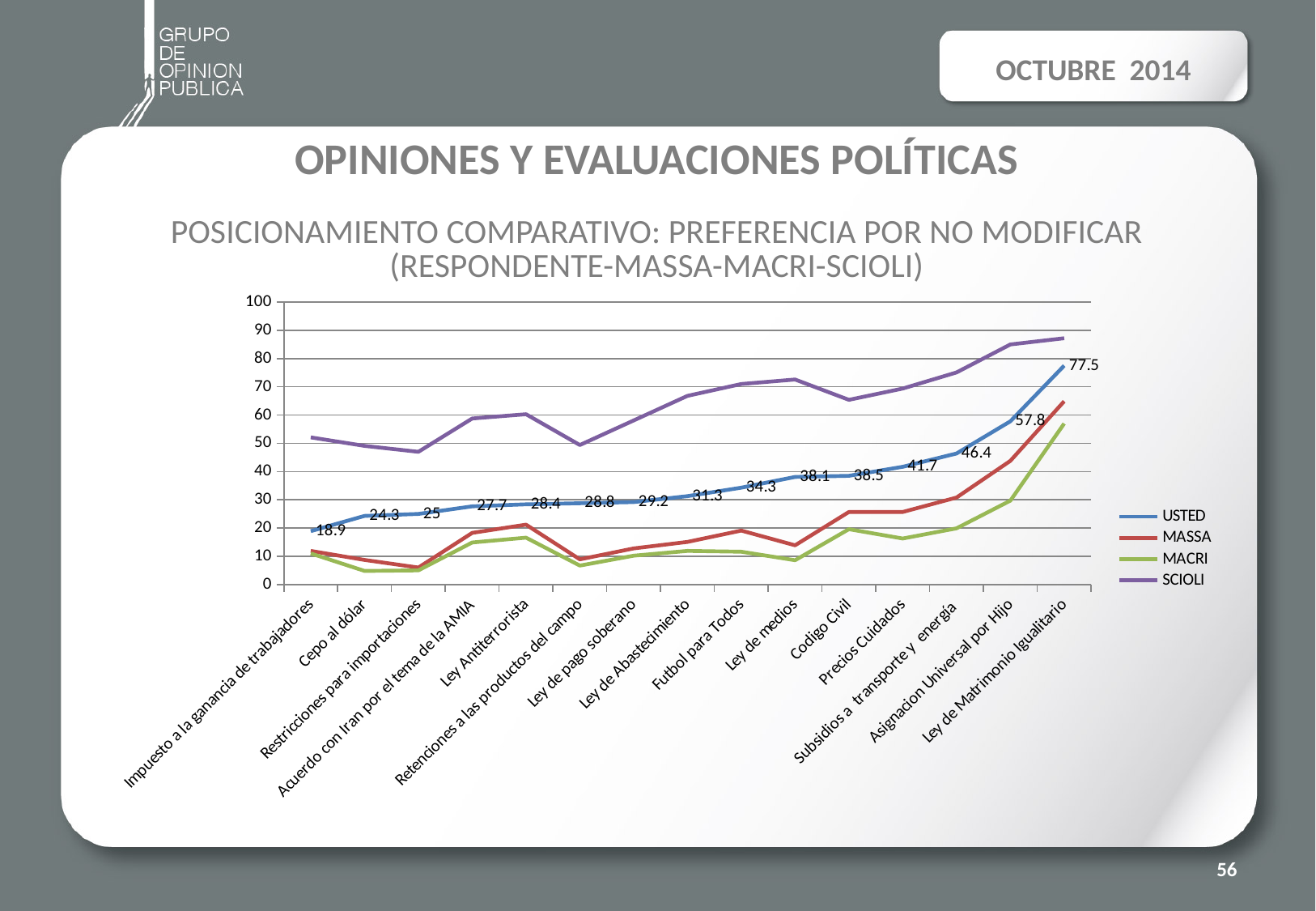
Which series has the higher value for Cepo al dólar, SCIOLI or MACRI? SCIOLI How many series does the legend list? 4 What is the USTED value for Ley de Matrimonio Igualitario? 77.5 Which category has the highest USTED value? Ley de Matrimonio Igualitario What is the difference between the USTED values for Ley de Matrimonio Igualitario and Asignacion Universal por Hijo? 19.7 Which category has the lowest USTED value? Impuesto a la ganancia de trabajadores Does the USTED series rise or fall from left to right along the x axis? Rise What is the USTED value for Impuesto a la ganancia de trabajadores? 18.9 How many categories are shown on the x axis? 15 Is the SCIOLI value for Ley de Matrimonio Igualitario greater or less than 80? greater What kind of chart is shown on the slide? Line chart What is the USTED value for Precios Cuidados? 41.7